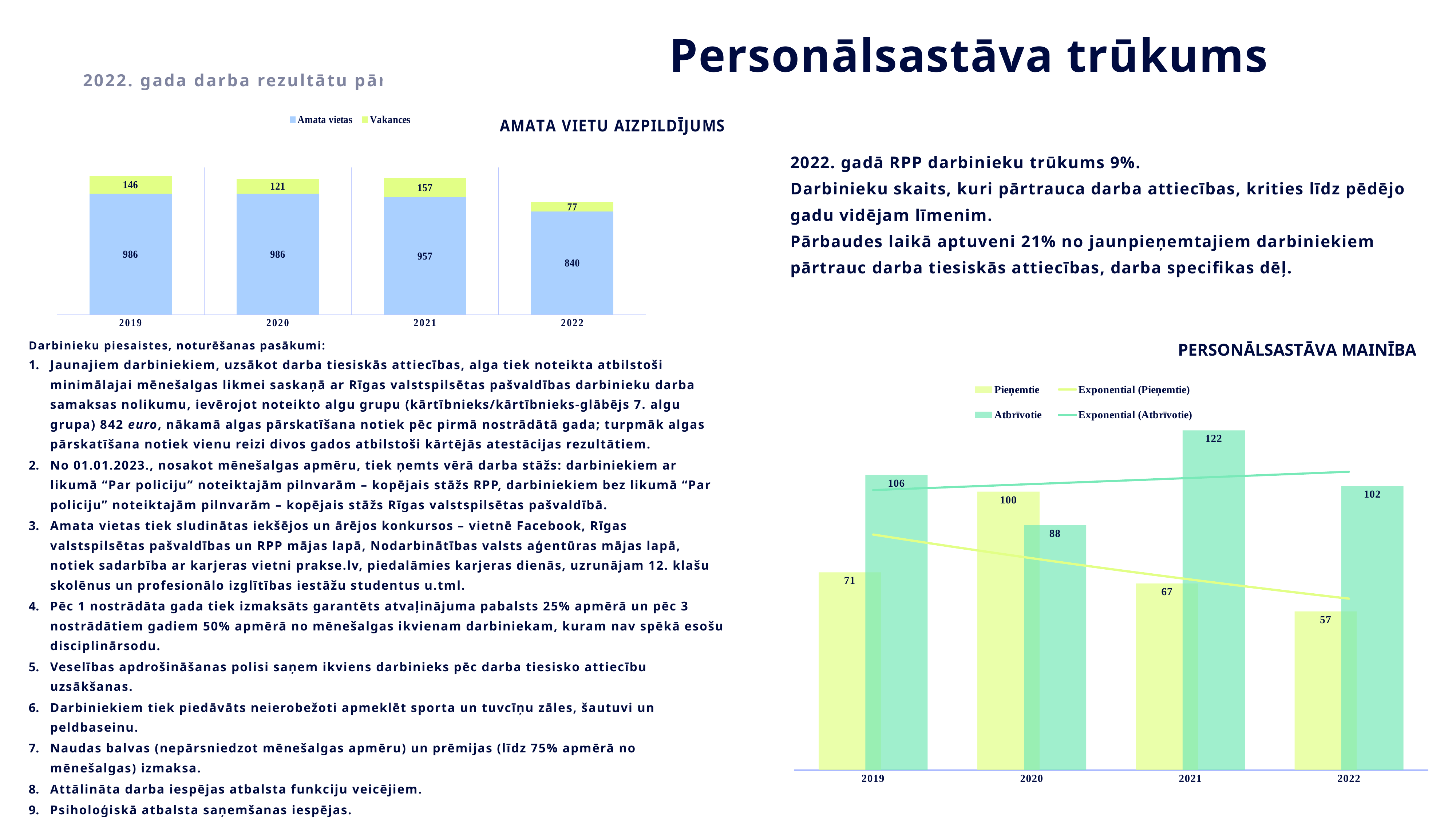
In the AMATA VIETU AIZPILDĪJUMS chart, what is the difference between the Vakances values for 2021 and 2022? 80 In the AMATA VIETU AIZPILDĪJUMS chart, what is the total of the stacked bar for 2019? 1132 In the PERSONĀLSASTĀVA MAINĪBA chart, which year has the highest Atbrīvotie value? 2021 In the PERSONĀLSASTĀVA MAINĪBA chart, which is larger for 2020: Pieņemtie or Atbrīvotie? Pieņemtie In the AMATA VIETU AIZPILDĪJUMS chart, which year has the lowest Vakances value? 2022 In the AMATA VIETU AIZPILDĪJUMS chart, what is the value of Vakances for 2021? 157 In the AMATA VIETU AIZPILDĪJUMS chart, what is the value of Amata vietas for 2022? 840 What kind of chart is the AMATA VIETU AIZPILDĪJUMS chart? Stacked bar chart How many years are shown on the x axis of the PERSONĀLSASTĀVA MAINĪBA chart? 4 How many series does the legend of the AMATA VIETU AIZPILDĪJUMS chart list? 2 In the PERSONĀLSASTĀVA MAINĪBA chart, what is the Pieņemtie value for 2020? 100 In the PERSONĀLSASTĀVA MAINĪBA chart, what is the difference between Atbrīvotie and Pieņemtie in 2022? 45